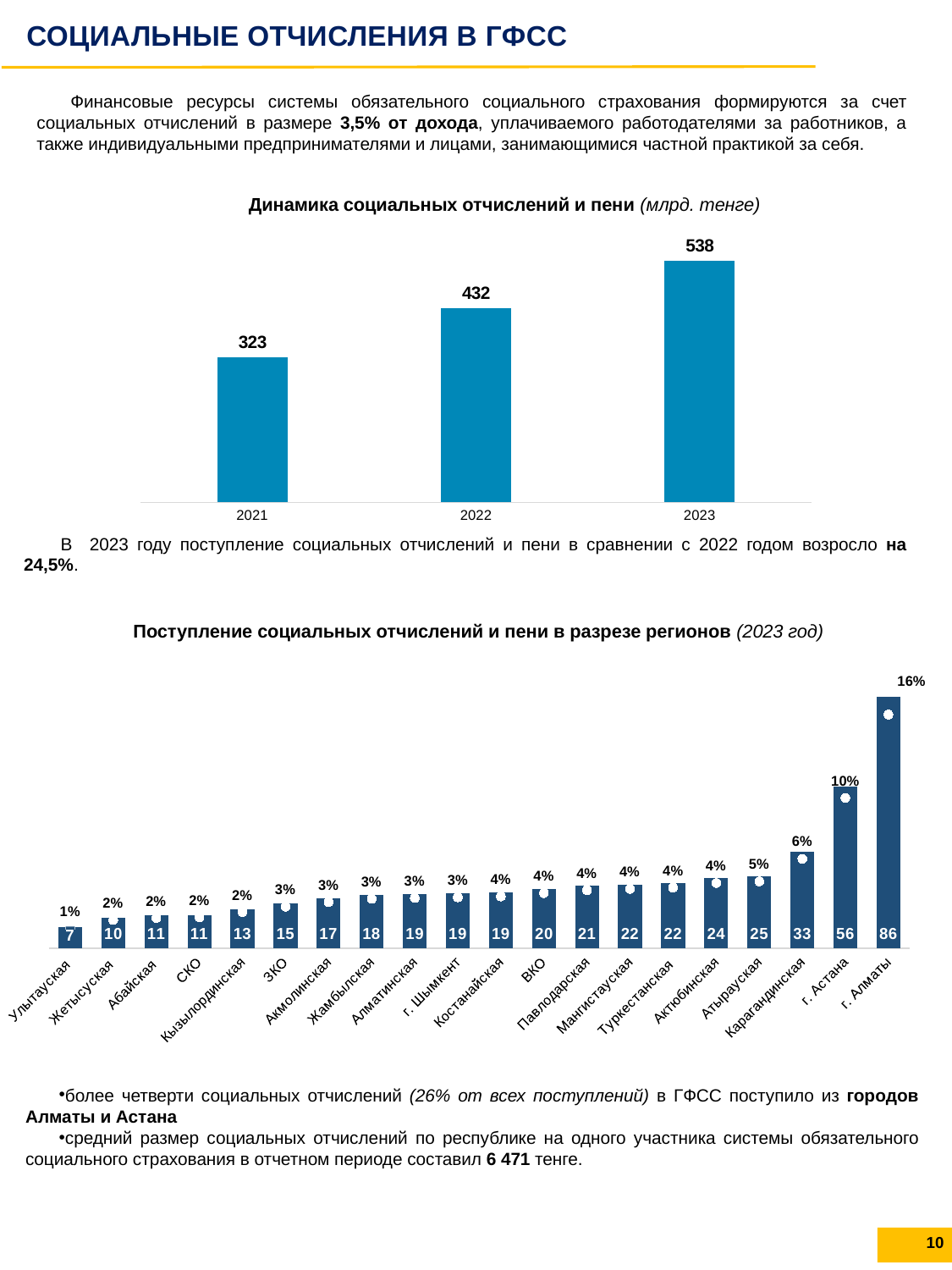
In the chart 'Динамика социальных отчислений и пени', what is the difference between the 2023 and 2021 values? 215 In the chart 'Динамика социальных отчислений и пени', do the values rise or fall from 2021 to 2023? rise In the chart 'Динамика социальных отчислений и пени', what is the value for 2022? 432 In the chart 'Поступление социальных отчислений и пени в разрезе регионов', how many regions are shown? 20 In the chart 'Поступление социальных отчислений и пени в разрезе регионов', which region has the lowest value? Улытауская In the chart 'Поступление социальных отчислений и пени в разрезе регионов', what is the difference between the values for г. Алматы and г. Астана? 30 In the chart 'Динамика социальных отчислений и пени', which year has the highest value? 2023 In the chart 'Динамика социальных отчислений и пени', how many years are shown? 3 In the chart 'Поступление социальных отчислений и пени в разрезе регионов', what is the value for г. Астана? 56 What kind of chart is 'Динамика социальных отчислений и пени'? bar chart In the chart 'Поступление социальных отчислений и пени в разрезе регионов', what percentage share is shown for г. Алматы? 16% In the chart 'Поступление социальных отчислений и пени в разрезе регионов', which is larger: Карагандинская or Атырауская? Карагандинская